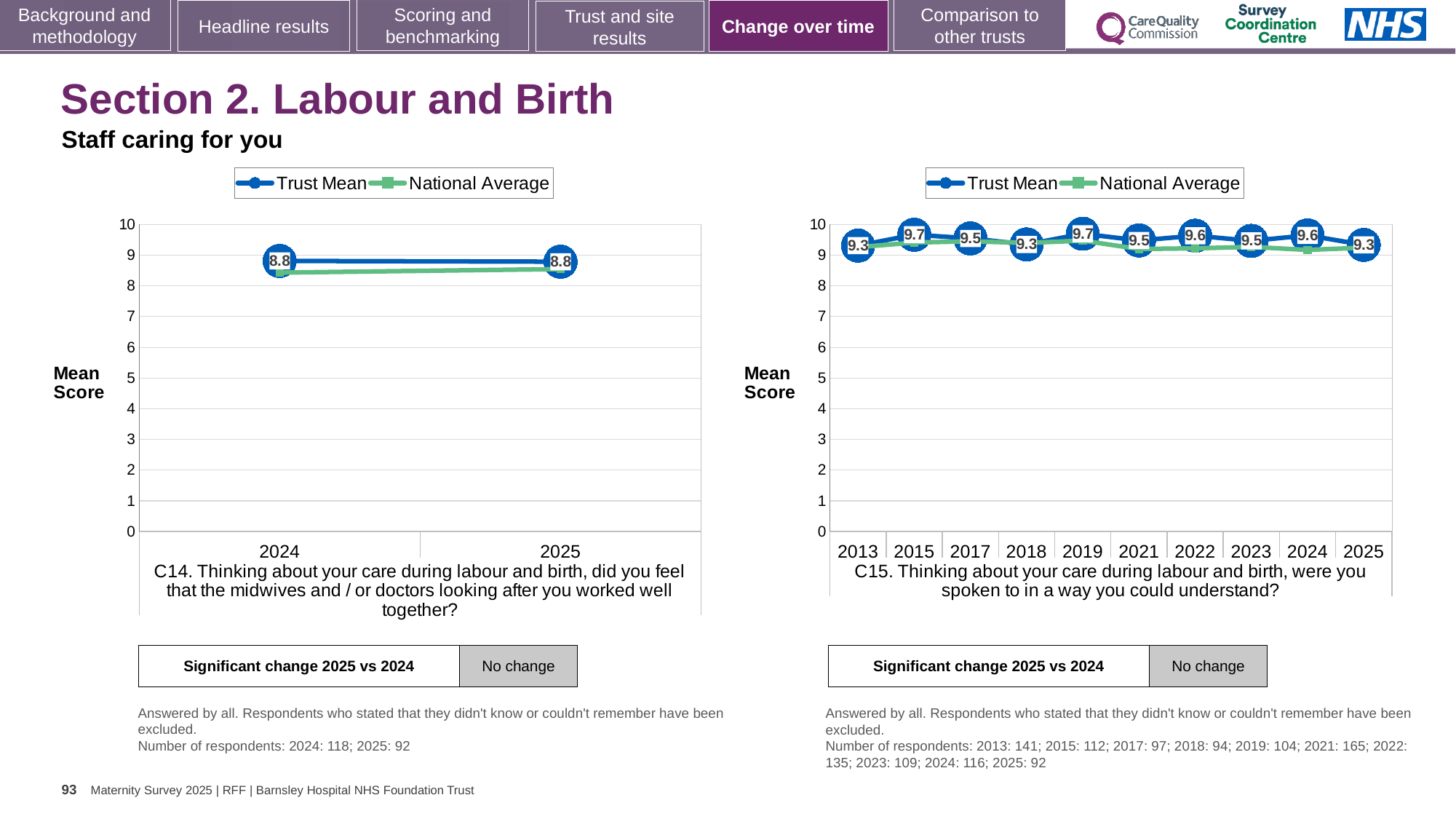
In the C15 chart on the right, which year has the larger Trust Mean, 2019 or 2018? 2019 In the C14 chart on the left, how many series does the legend list? 2 In the C15 chart on the right, how many years are plotted on the x axis? 10 What kind of chart is the C15 chart on the right? Line chart In the C15 chart on the right, what is the Trust Mean for 2025? 9.3 In the C15 chart on the right, what is the Trust Mean for 2022? 9.6 In the C15 chart on the right, what is the Trust Mean for 2015? 9.7 In the C14 chart on the left, what is the Trust Mean for 2024? 8.8 In the C14 chart on the left, does the Trust Mean rise, fall or stay the same from 2024 to 2025? Stays the same In the C15 chart on the right, what is the difference between the Trust Mean for 2015 and the Trust Mean for 2013? 0.4 In the C14 chart on the left, is the National Average for 2024 greater or less than 8? greater In the C14 chart on the left, what is the Trust Mean for 2025? 8.8